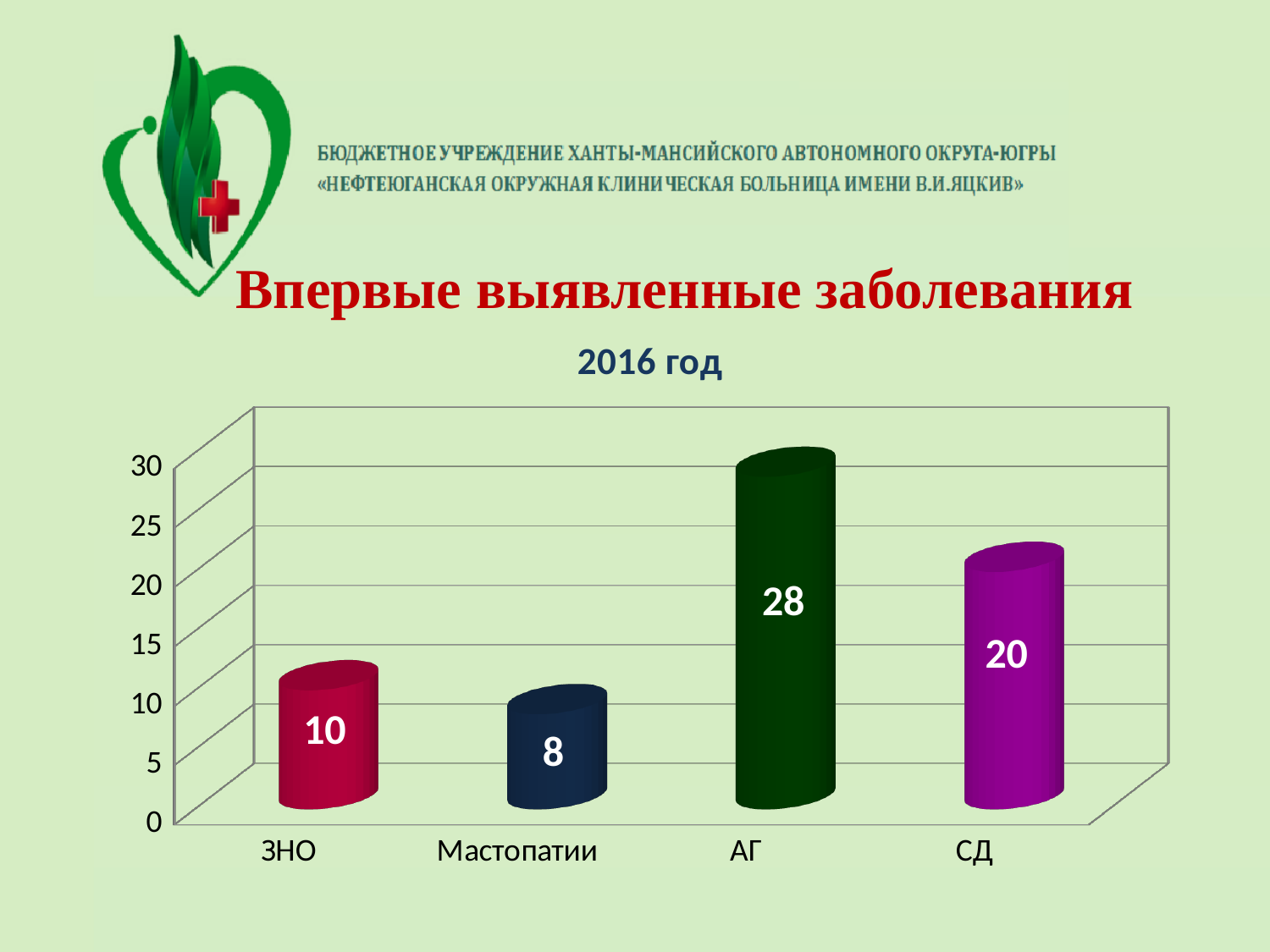
What is the value for АГ? 28 What is the value for Мастопатии? 8 What kind of chart is shown on the slide? bar chart Which category has the lowest value? Мастопатии How many categories are shown on the chart? 4 Is the value for СД greater or less than 15? greater What is the value for СД? 20 What is the difference between the values for АГ and СД? 8 Which category has the highest value? АГ What is the value for ЗНО? 10 What is the title of the chart? 2016 год Which is larger, the value for ЗНО or the value for Мастопатии? ЗНО